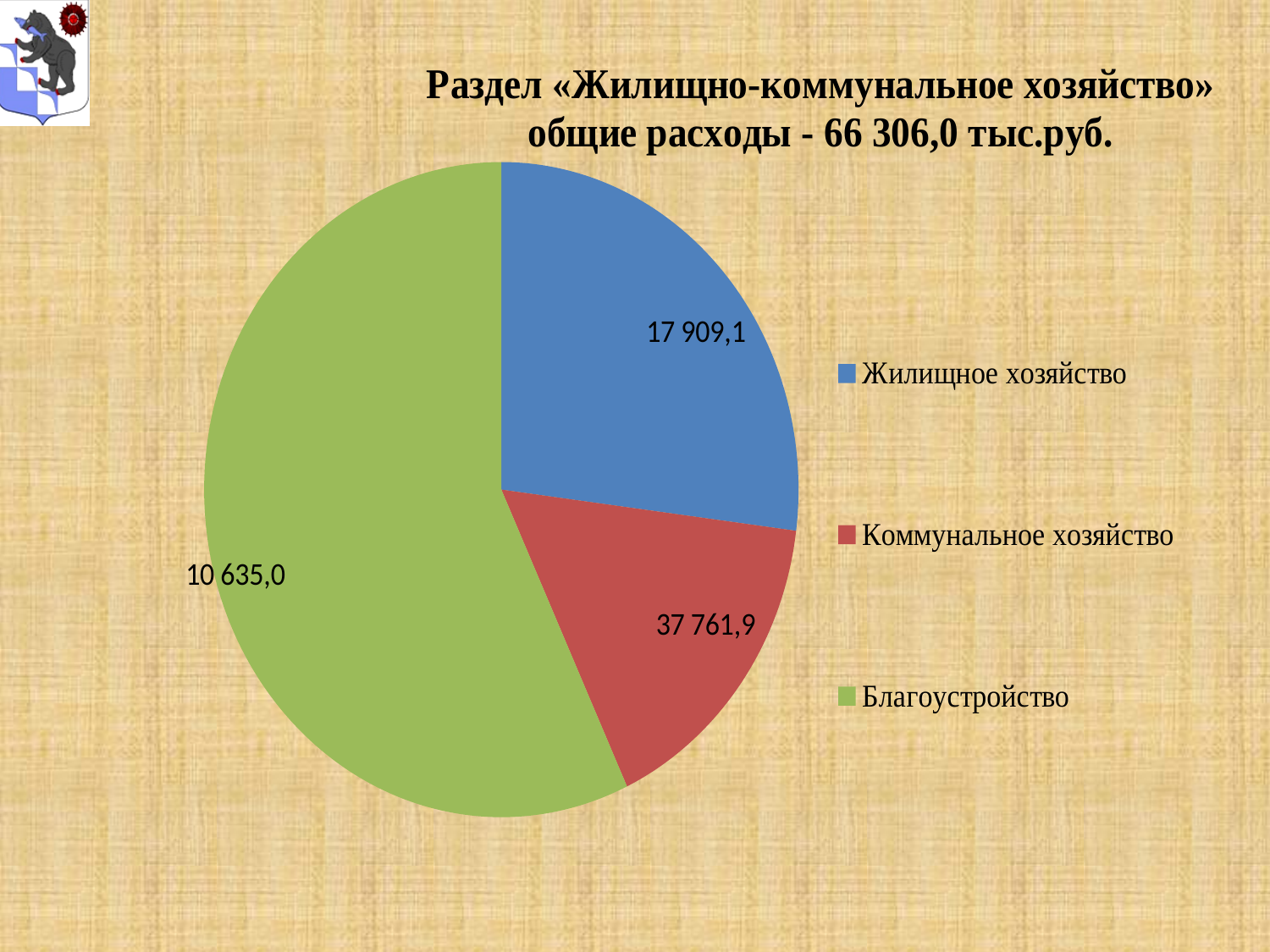
How many entries does the legend list? 3 What is the largest value printed as a data label on the chart? 37 761,9 How many slices does the pie chart have? 3 What value is printed on the Жилищное хозяйство slice? 17 909,1 Which slice is larger, Жилищное хозяйство or Коммунальное хозяйство? Жилищное хозяйство What is the smallest value printed as a data label on the chart? 10 635,0 What total expenditure is stated in the chart title? 66 306,0 тыс.руб. What kind of chart is shown on the slide? pie chart Which category has the largest slice of the pie? Благоустройство Which category has the smallest slice of the pie? Коммунальное хозяйство Which slice is larger, Благоустройство or Жилищное хозяйство? Благоустройство What colour is the Благоустройство slice? green